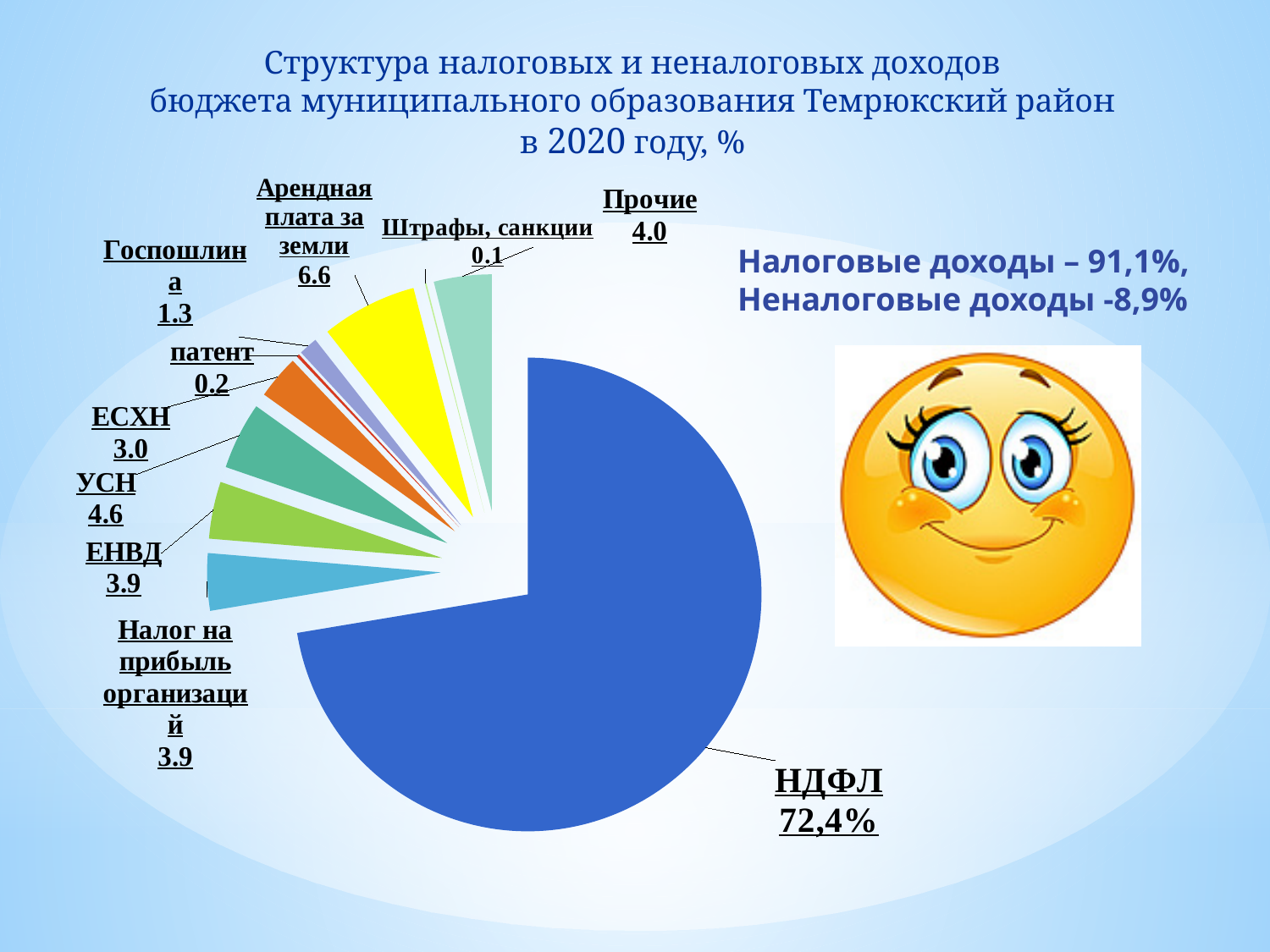
What share of the pie does НДФЛ have? 72,4% How many slices does the pie chart have? 10 What is the value shown for Прочие? 4.0 What is the value shown for Госпошлина? 1.3 Which is larger, the value for УСН or the value for ЕНВД? УСН What is the value shown for Арендная плата за земли? 6.6 What colour is the НДФЛ slice of the pie? blue Which category has the largest slice of the pie? НДФЛ What kind of chart is shown on the slide? pie chart What is the difference between the values for Арендная плата за земли and УСН? 2.0 What is the value shown for УСН? 4.6 Which category has the smallest slice of the pie? Штрафы, санкции